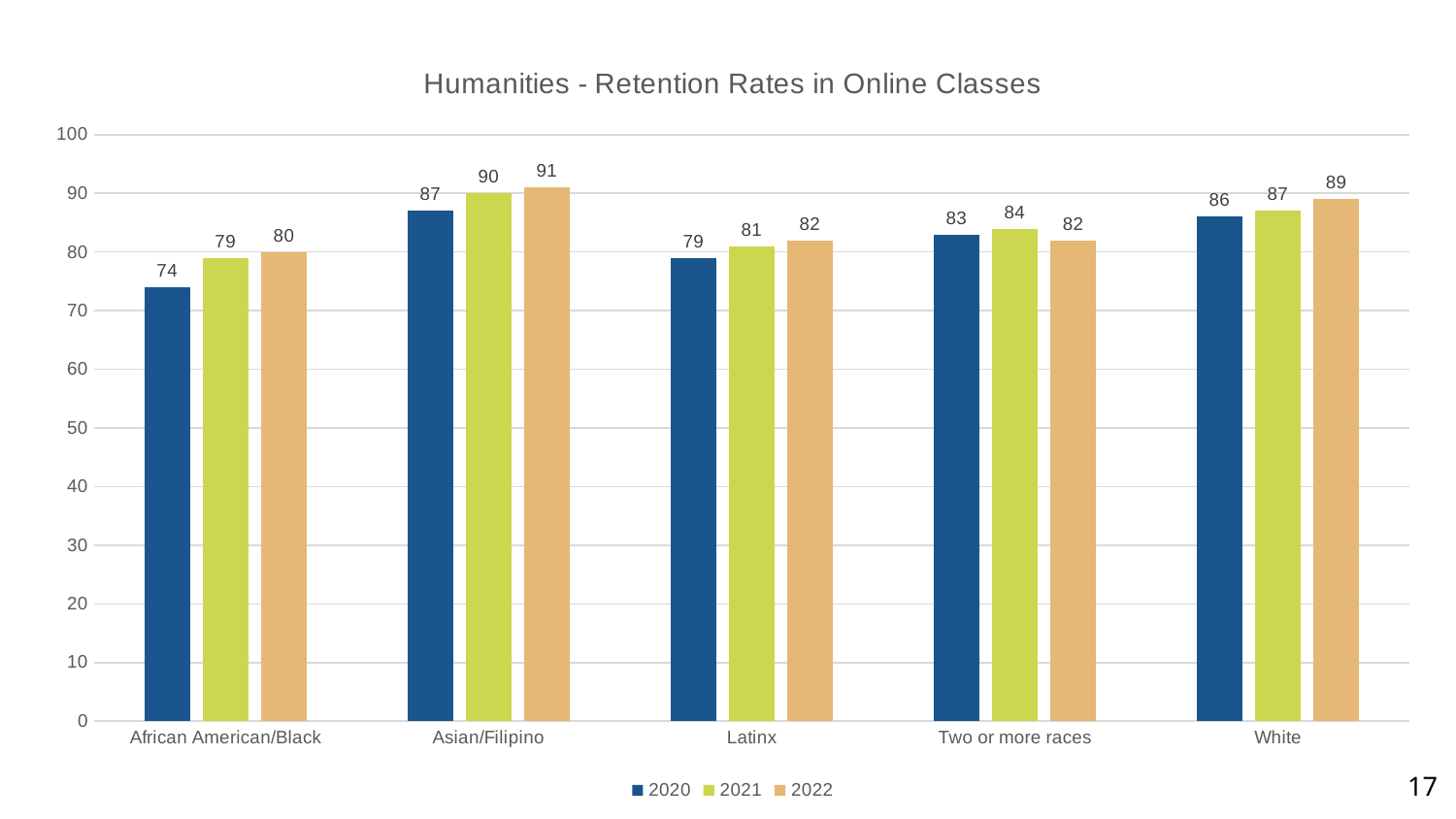
What is the title of the chart? Humanities - Retention Rates in Online Classes Which category has the highest 2022 retention rate? Asian/Filipino What kind of chart is shown on the slide? Bar chart How many series does the legend list? 3 Which category has the lowest 2020 retention rate? African American/Black Which is larger, the 2022 retention rate for Latinx or for Two or more races? Neither; both are 82 What is the difference between the 2022 and 2020 retention rates for African American/Black students? 6 How many categories are shown on the x axis? 5 What is the 2021 retention rate for Two or more races? 84 Do the retention rates for White students rise or fall from 2020 to 2022? Rise What is the 2022 retention rate for Asian/Filipino students? 91 What is the 2020 retention rate for African American/Black students? 74